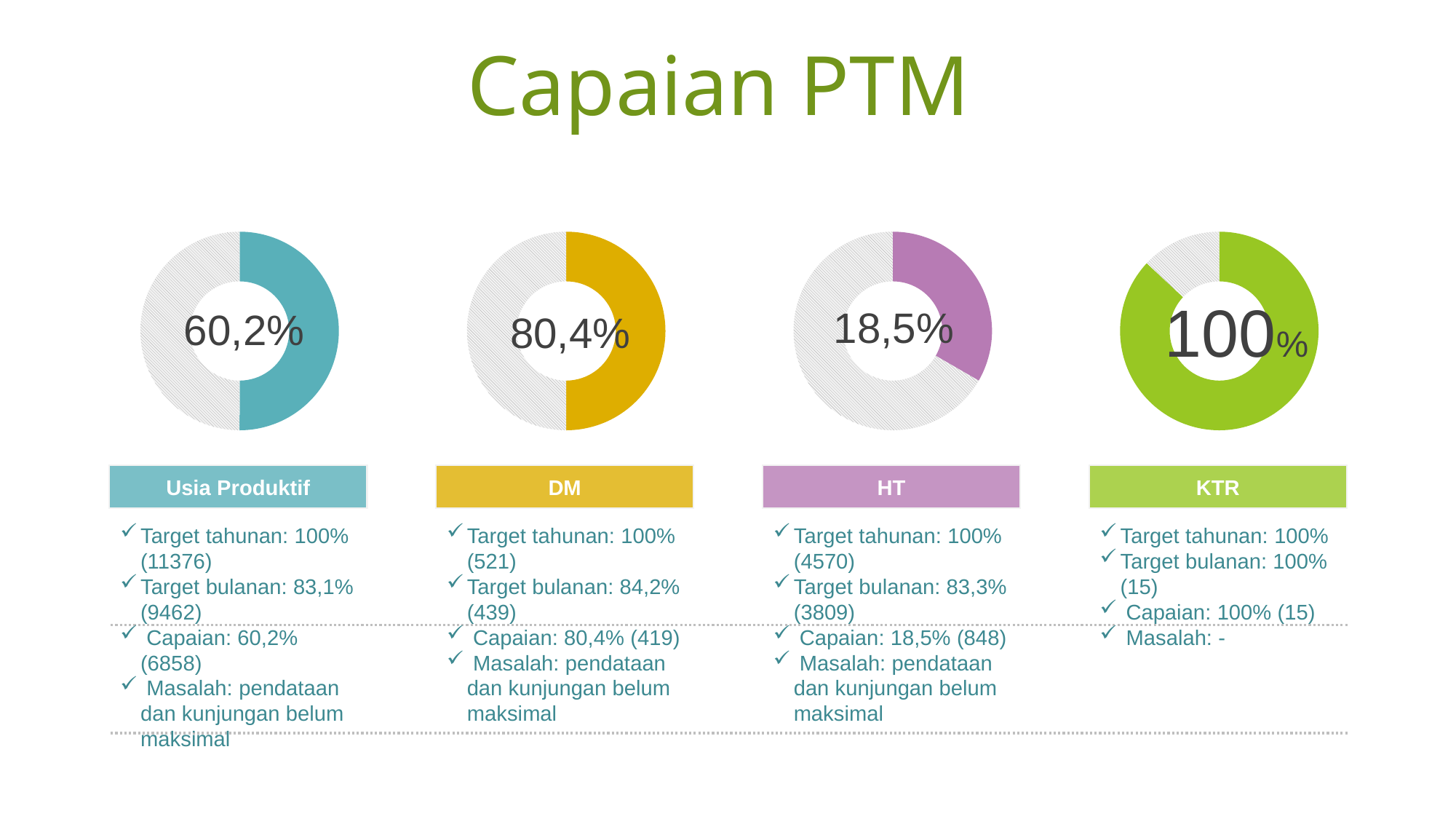
What value is shown in the centre of the HT donut chart? 18,5% Which of the four donut charts shows the highest percentage? KTR What value is shown in the centre of the KTR donut chart? 100% What value is shown in the centre of the DM donut chart? 80,4% What value is shown in the centre of the Usia Produktif donut chart? 60,2% What colour is the filled portion of the HT donut chart? Purple What kind of chart is used to show the Capaian for each category on this slide? Donut chart Which of the four donut charts shows the lowest percentage? HT What is the difference between the percentage in the DM donut chart and the percentage in the HT donut chart? 61,9% Which shows a larger percentage, the DM donut chart or the Usia Produktif donut chart? DM What is the difference between the percentage in the KTR donut chart and the percentage in the Usia Produktif donut chart? 39,8% How many donut charts are shown on the slide? 4